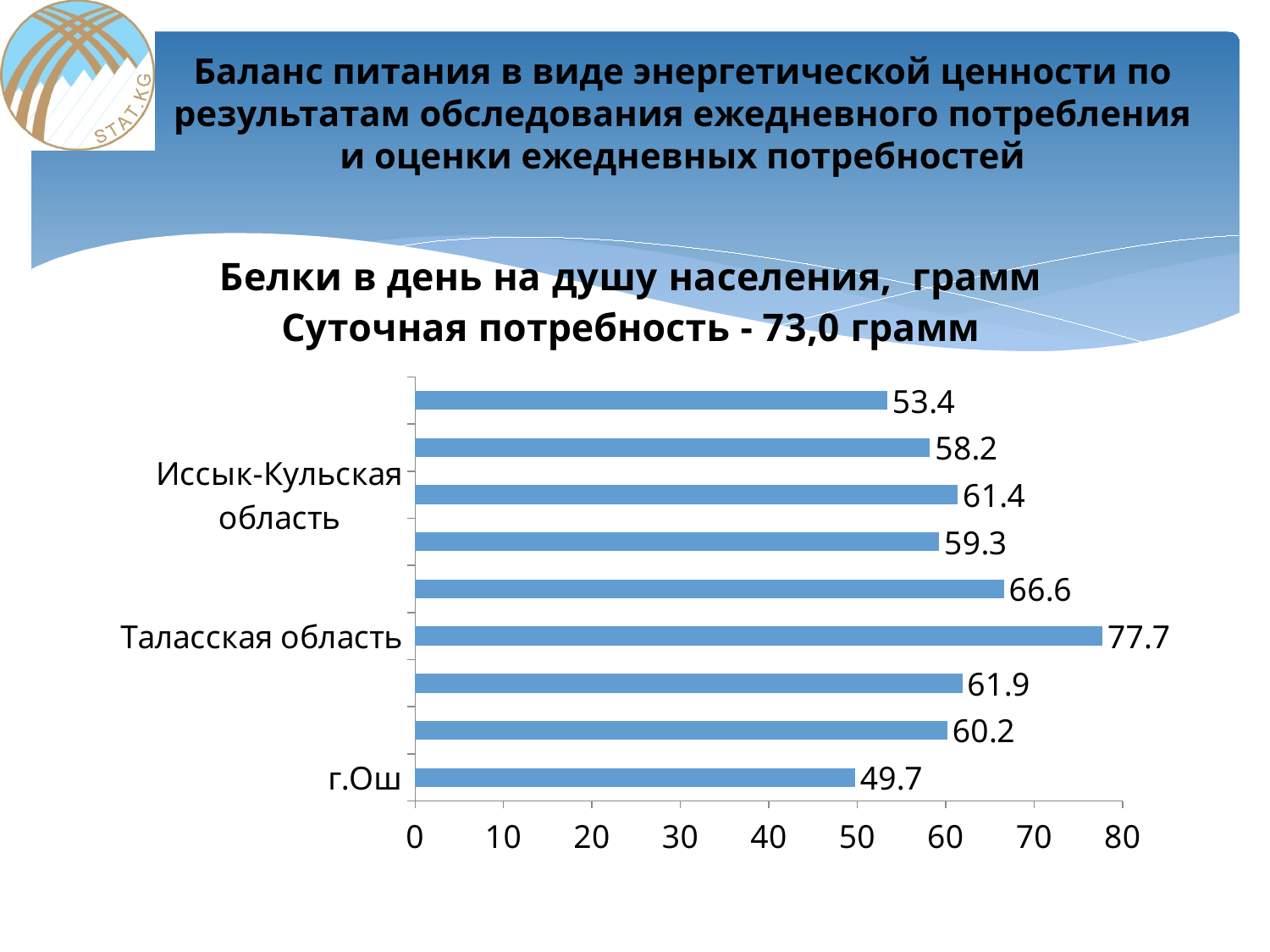
What is the value for Иссык-Кульская область? 61.4 Which labelled region has the lowest value? г.Ош What is the value for г.Ош? 49.7 Which is larger, the value for Иссык-Кульская область or the value for г.Ош? Иссык-Кульская область According to the chart title, what is the daily requirement of protein in grams? 73,0 грамм What is the value for Таласская область? 77.7 What is the difference between the values for Таласская область and г.Ош? 28.0 Is the value for Таласская область greater or less than 70? greater What is the value shown on the topmost bar of the chart? 53.4 What type of chart is shown on the slide? bar chart How many bars are plotted in the chart? 9 Which labelled region has the highest value? Таласская область